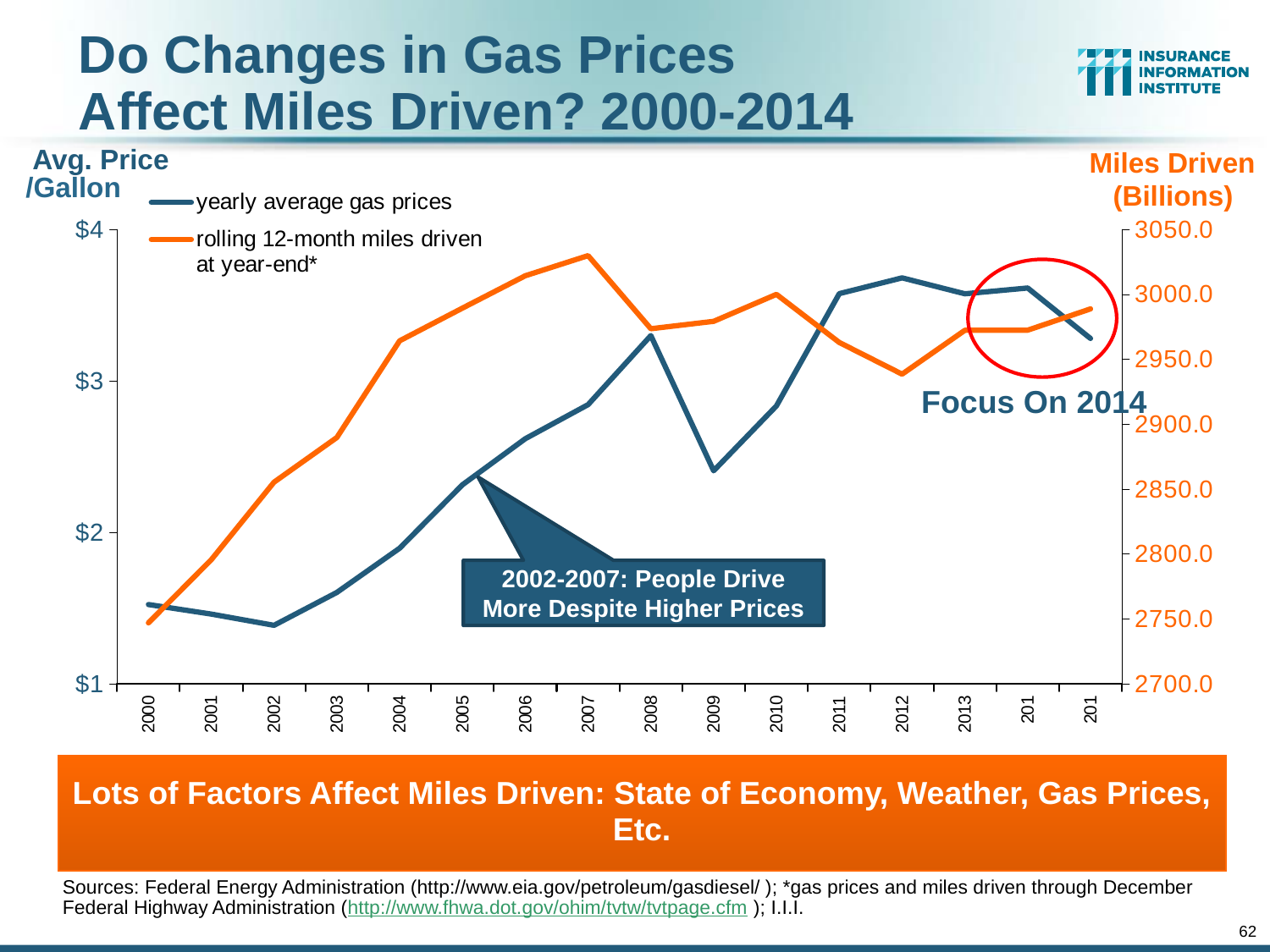
Which series is drawn in orange according to the legend? rolling 12-month miles driven at year-end* In which year were rolling 12-month miles driven lowest? 2000 In which year was the yearly average gas price highest? 2012 Which year had the higher yearly average gas price, 2008 or 2009? 2008 Is the yearly average gas price for 2010 greater or less than $3? less Are the rolling 12-month miles driven for 2000 greater or less than 2800.0? less What is the label of the left vertical axis? Avg. Price /Gallon Is the yearly average gas price for 2008 greater or less than $3? greater How many series does the chart's legend list? 2 In which year were rolling 12-month miles driven highest? 2007 What kind of chart is shown on the slide? line chart In which year was the yearly average gas price lowest? 2002